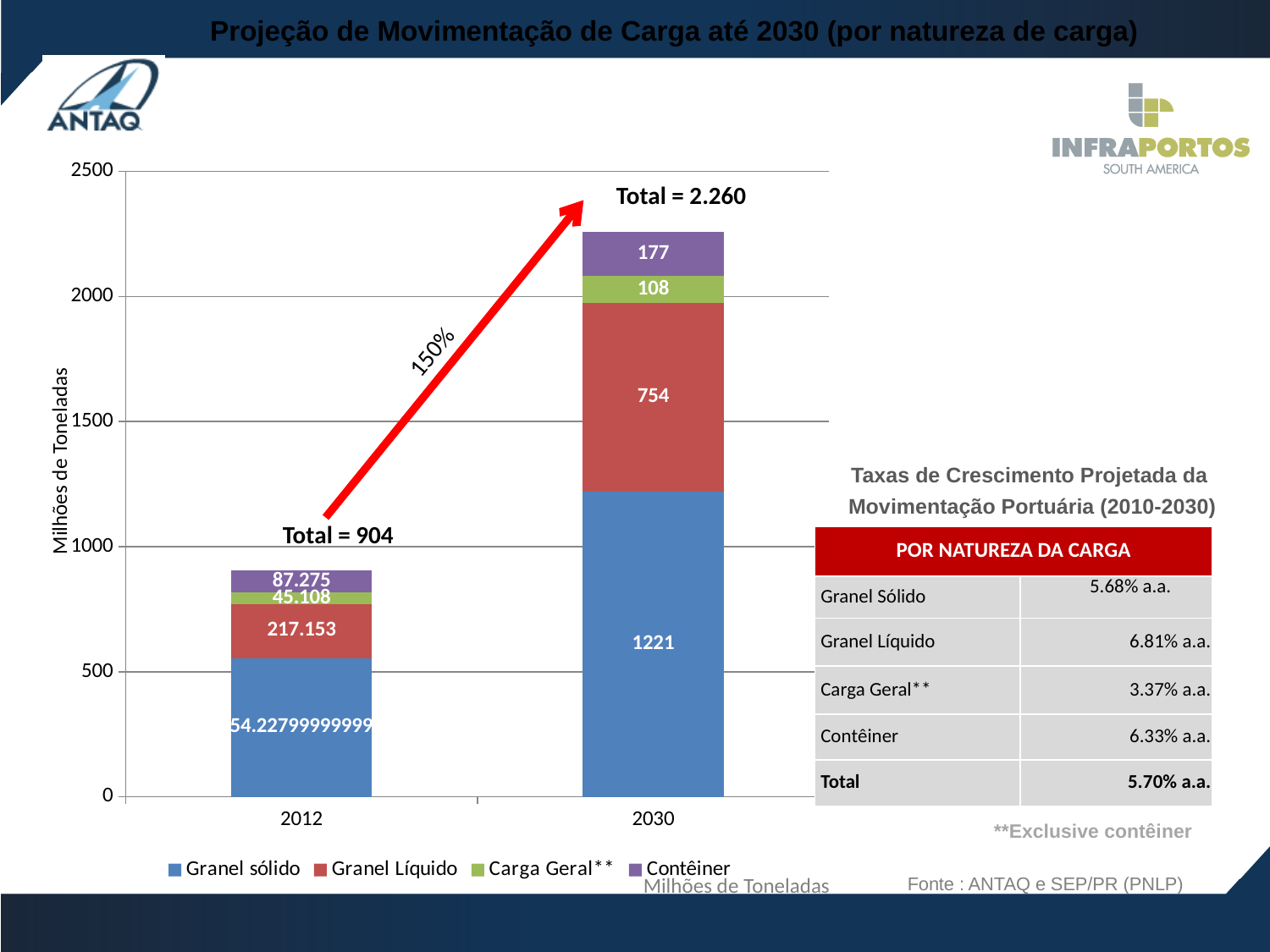
How many years (categories) are plotted on the x axis? 2 What is the value for Granel sólido in 2030? 1221 What is the total of the stacked bar for 2012? 904 What is the difference between the Contêiner value in 2030 and the Carga Geral** value in 2030? 69 What is the value for Granel Líquido in 2030? 754 What kind of chart is shown on the slide? Stacked bar chart How many series does the chart legend list? 4 What is the total of the stacked bar for 2030? 2.260 Which series has the largest value in 2030? Granel sólido What is the value for Contêiner in 2012? 87.275 Does the total cargo movement rise or fall from 2012 to 2030? Rise What is the value for Carga Geral** in 2012? 45.108